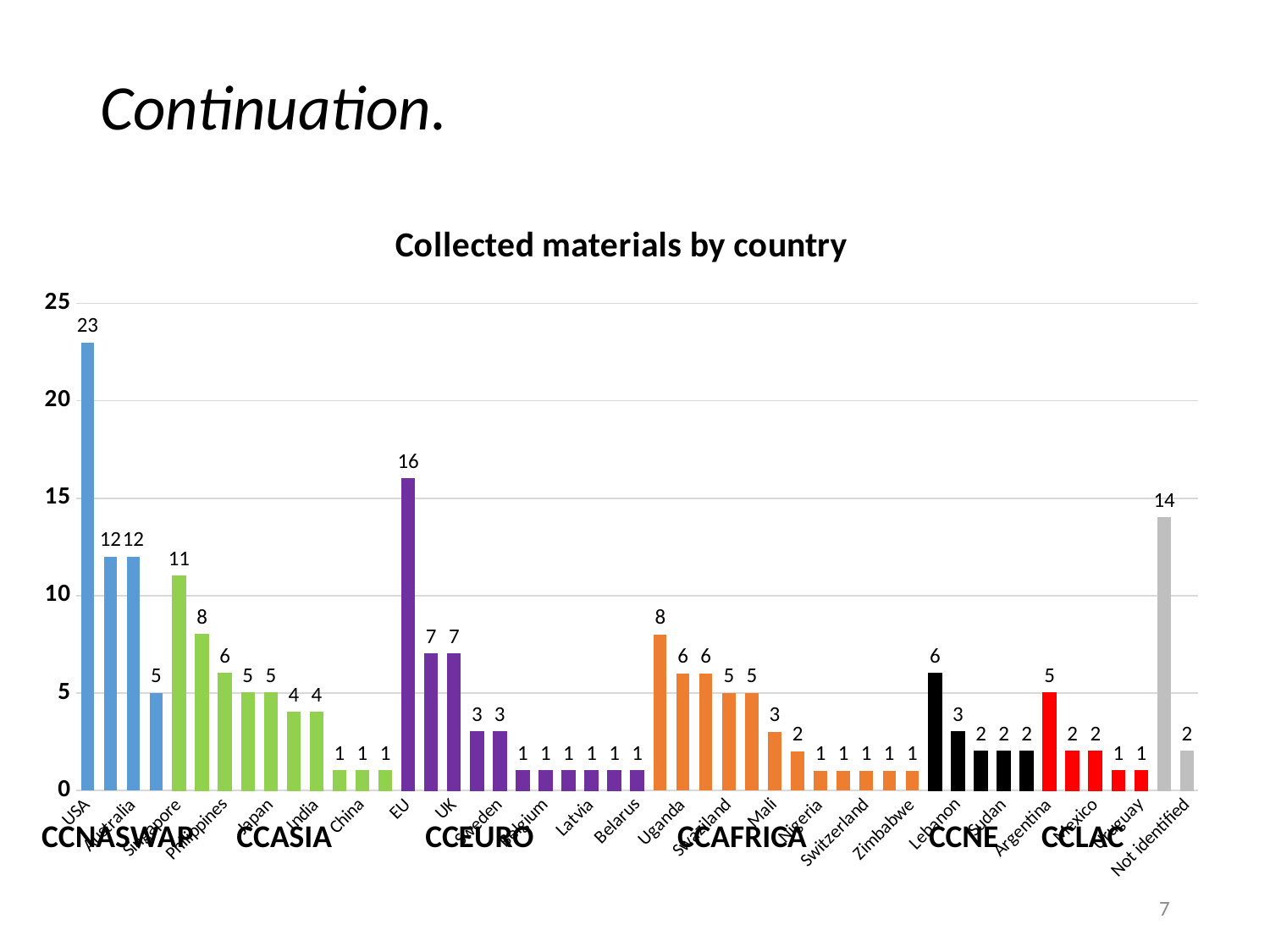
What kind of chart is shown on the slide? Bar chart Which country has the highest value in the 'Collected materials by country' chart? USA What is the value for Australia in the 'Collected materials by country' chart? 12 What is the value for USA in the 'Collected materials by country' chart? 23 What is the title of the chart on the slide? Collected materials by country Is the value for EU greater or less than 15? greater What is the difference between the values for USA and Australia in the chart? 11 Which is larger in the chart, the value for USA or the value for EU? USA Is the value for USA greater or less than 20? greater What is the difference between the values for USA and EU in the chart? 7 What is the highest value shown on the vertical axis of the chart? 25 What is the value for EU in the 'Collected materials by country' chart? 16